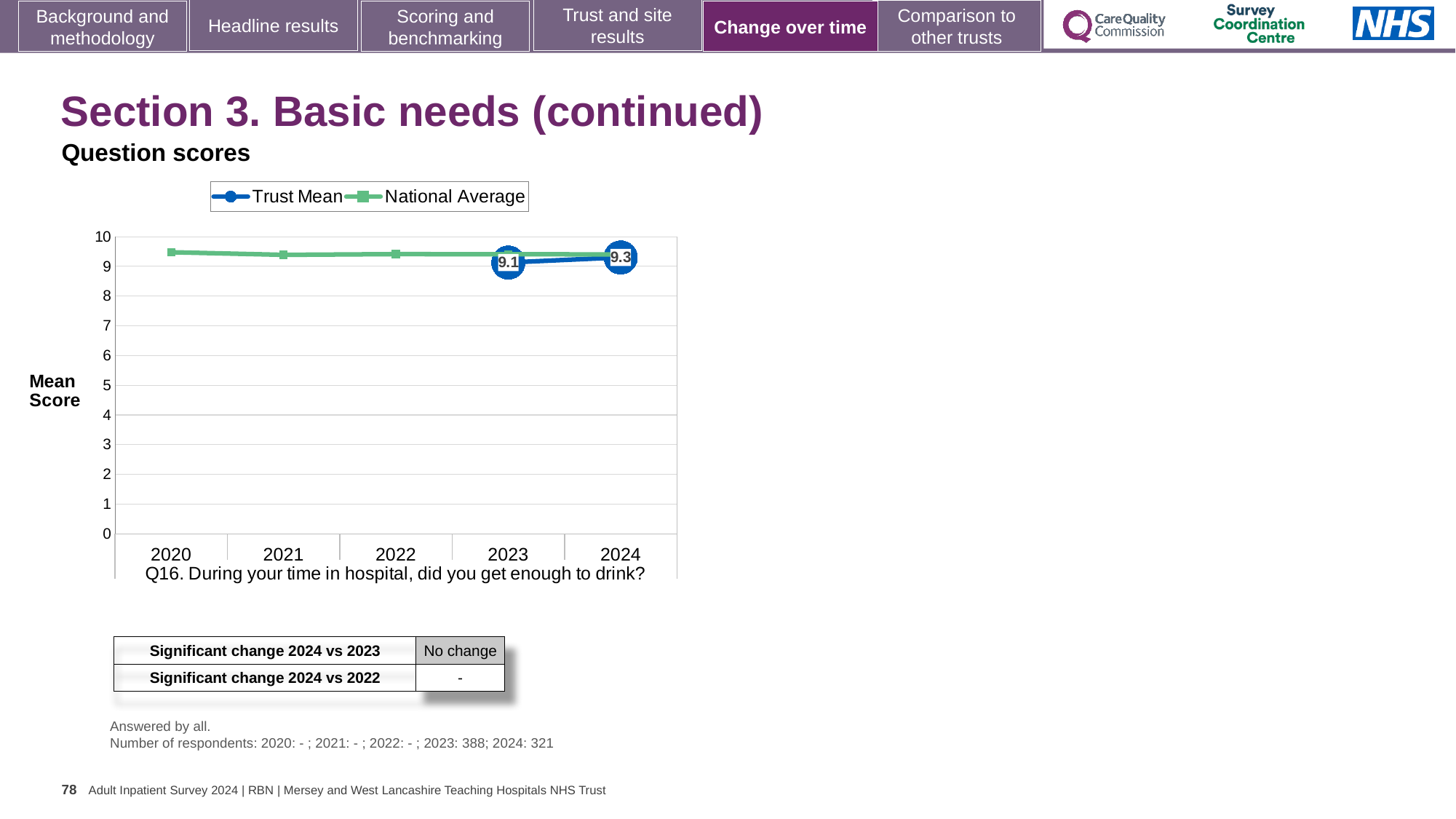
What is the Trust Mean score for 2023? 9.1 Does the Trust Mean line rise or fall from 2023 to 2024? rise How many years are shown on the x axis of the chart? 5 What kind of chart is shown on the slide? line chart Which series is shown in green in the chart? National Average What is the Trust Mean score for 2024? 9.3 What is the label of the y axis of the chart? Mean Score By how much did the Trust Mean score change from 2023 to 2024? 0.2 Is the National Average value for 2020 greater or less than 9? greater Which year has the higher Trust Mean score, 2023 or 2024? 2024 How many series does the chart legend list? 2 Is the Trust Mean value for 2023 greater or less than 8? greater